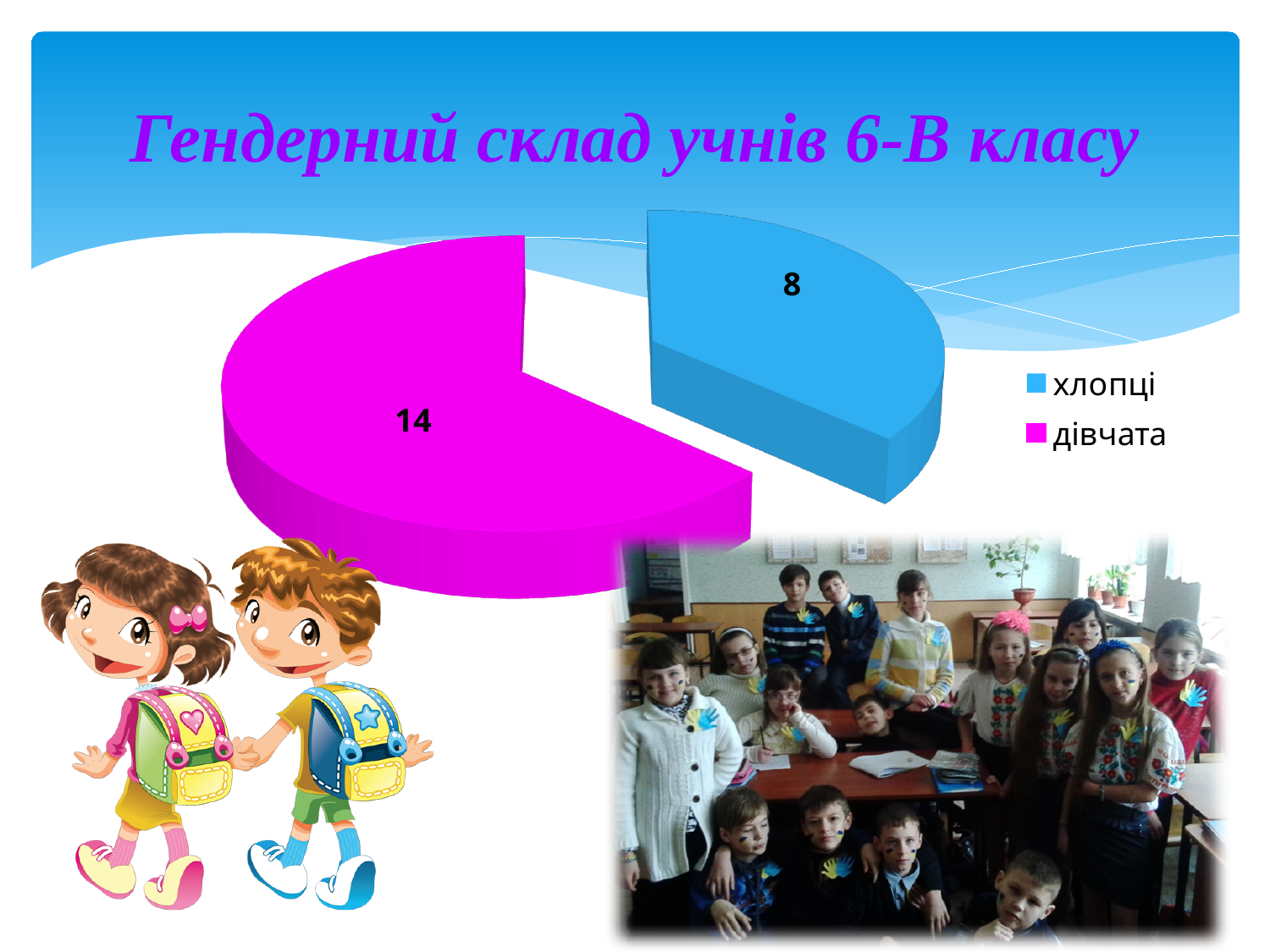
What kind of chart is shown on the slide? pie chart Which category has the largest slice? дівчата What is the total of all slices in the pie chart? 22 What is the title of the chart? Гендерний склад учнів 6-В класу What is the difference between the values for дівчата and хлопці? 6 Which category has the smallest slice? хлопці How many categories does the pie chart have? 2 What is the value for хлопці? 8 What is the value for дівчата? 14 How many entries does the legend list? 2 What colour is the slice for хлопці? blue Which is larger, the value for хлопці or the value for дівчата? дівчата